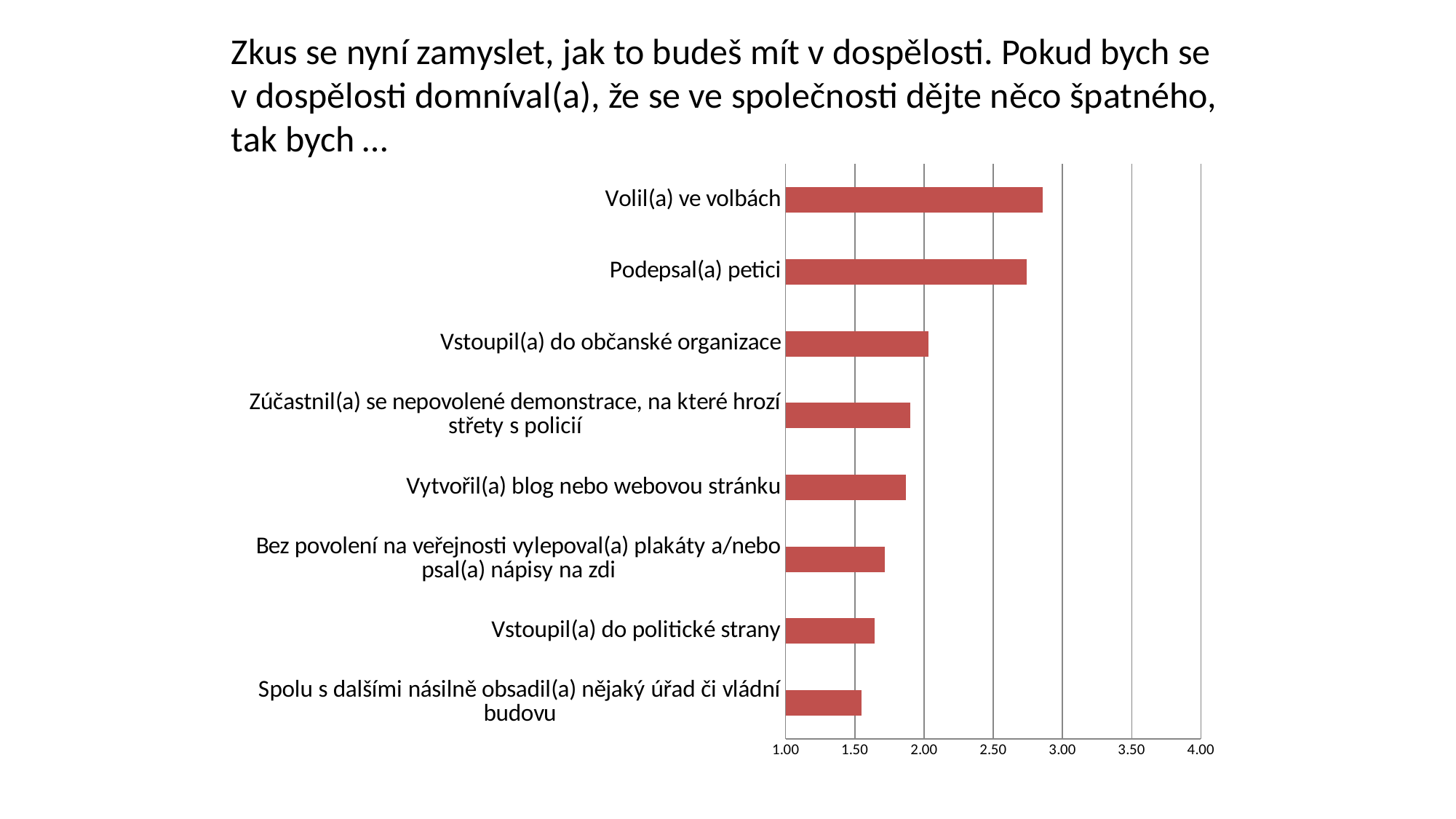
Which has the larger value: Vstoupil(a) do občanské organizace or Vstoupil(a) do politické strany? Vstoupil(a) do občanské organizace How many categories (bars) does the chart show? 8 Is the value for Volil(a) ve volbách greater or less than 2.50? greater Which has the larger value: Volil(a) ve volbách or Podepsal(a) petici? Volil(a) ve volbách Is the value for Vstoupil(a) do občanské organizace greater or less than 2.50? less What kind of chart is shown on the slide? bar chart Which category has the lowest value? Spolu s dalšími násilně obsadil(a) nějaký úřad či vládní budovu Is the value for Vytvořil(a) blog nebo webovou stránku greater or less than 2.00? less Which category has the highest value? Volil(a) ve volbách